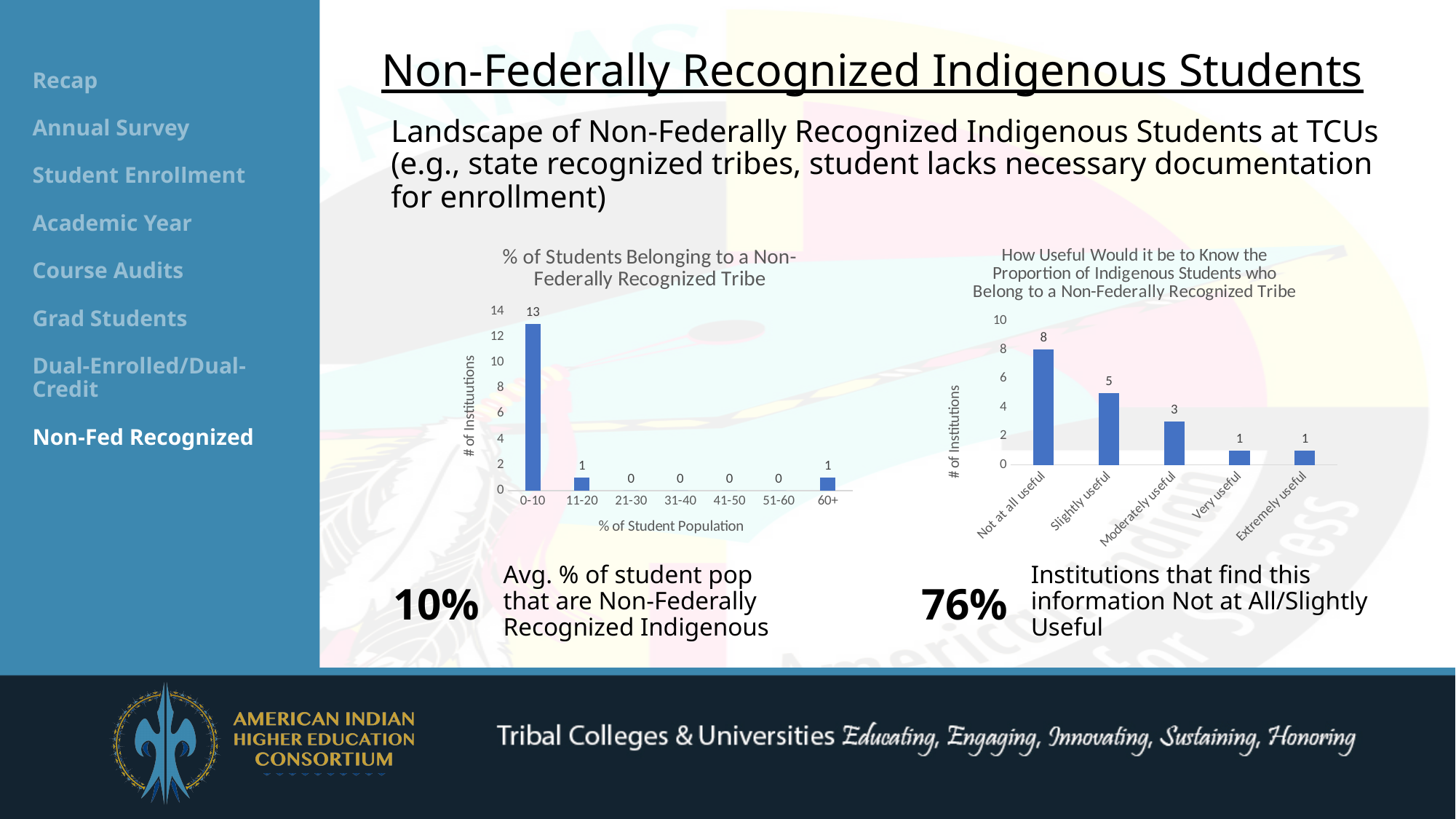
In the left chart '% of Students Belonging to a Non-Federally Recognized Tribe', how many institutions are in the 0-10 category? 13 In the left chart '% of Students Belonging to a Non-Federally Recognized Tribe', what is the difference between the 0-10 and 11-20 values? 12 In the left chart '% of Students Belonging to a Non-Federally Recognized Tribe', which category has the highest number of institutions? 0-10 In the right chart 'How Useful Would it be to Know the Proportion of Indigenous Students who Belong to a Non-Federally Recognized Tribe', how many institutions answered 'Moderately useful'? 3 In the left chart '% of Students Belonging to a Non-Federally Recognized Tribe', what is the value for the 60+ category? 1 In the left chart '% of Students Belonging to a Non-Federally Recognized Tribe', how many categories are shown on the x axis? 7 What type of chart is the right chart 'How Useful Would it be to Know the Proportion of Indigenous Students who Belong to a Non-Federally Recognized Tribe'? Bar chart In the right chart 'How Useful Would it be to Know the Proportion of Indigenous Students who Belong to a Non-Federally Recognized Tribe', which is larger: 'Slightly useful' or 'Moderately useful'? Slightly useful In the left chart '% of Students Belonging to a Non-Federally Recognized Tribe', how many institutions are in the 11-20 category? 1 In the right chart 'How Useful Would it be to Know the Proportion of Indigenous Students who Belong to a Non-Federally Recognized Tribe', how many institutions answered 'Not at all useful'? 8 In the right chart 'How Useful Would it be to Know the Proportion of Indigenous Students who Belong to a Non-Federally Recognized Tribe', which response category has the highest value? Not at all useful In the right chart 'How Useful Would it be to Know the Proportion of Indigenous Students who Belong to a Non-Federally Recognized Tribe', what is the difference between 'Not at all useful' and 'Slightly useful'? 3